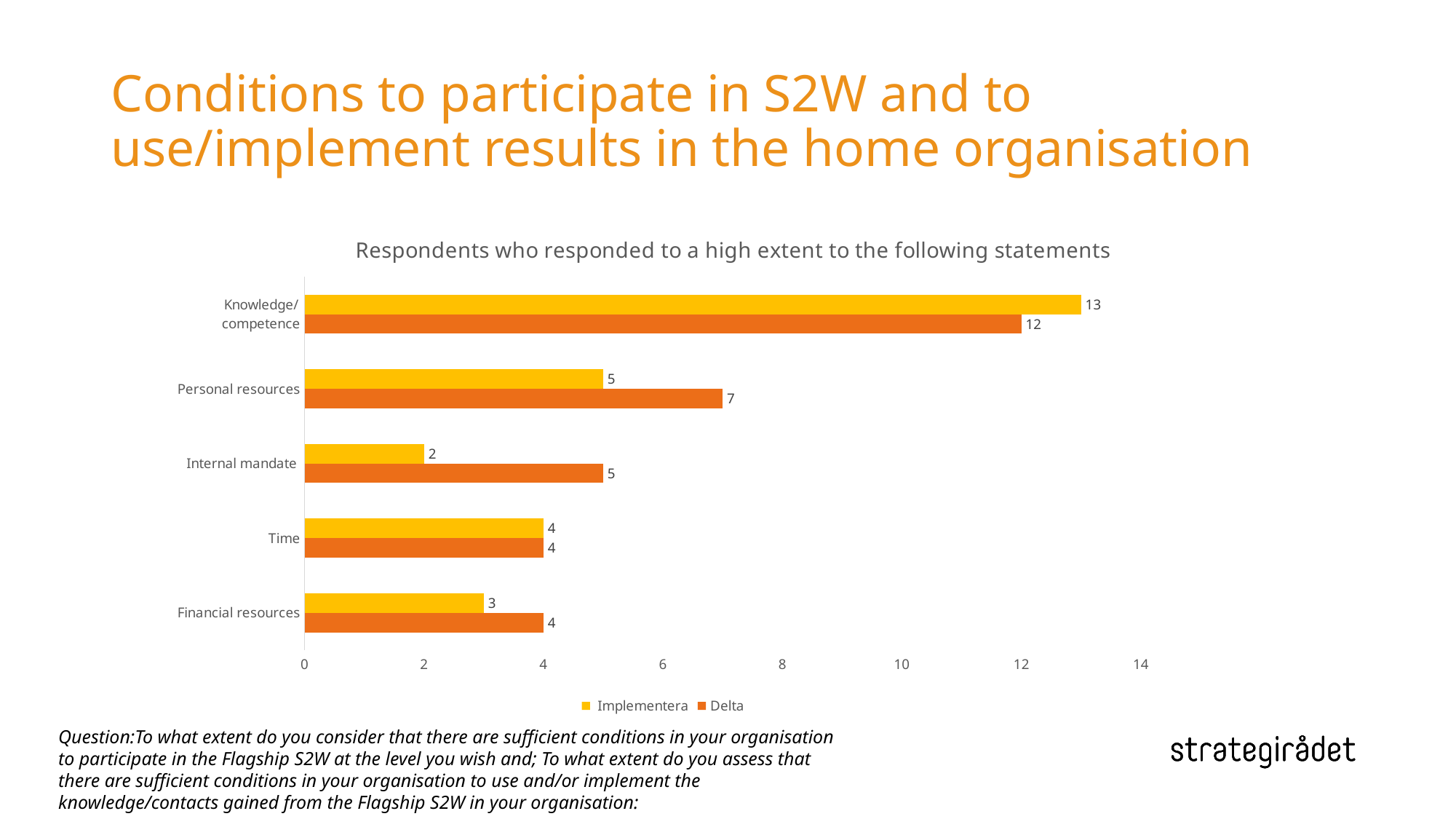
How many categories are shown on the chart? 5 How many series does the legend list? 2 What kind of chart is shown on the slide? Bar chart What is the Delta value for Financial resources? 4 What is the Delta value for Personal resources? 7 What is the Implementera value for Knowledge/competence? 13 Which category has the lowest Implementera value? Internal mandate What is the title of the chart? Respondents who responded to a high extent to the following statements What is the Implementera value for Internal mandate? 2 What is the difference between the Delta and Implementera values for Internal mandate? 3 Which category has the highest Delta value? Knowledge/competence For Personal resources, which series has the larger value, Implementera or Delta? Delta